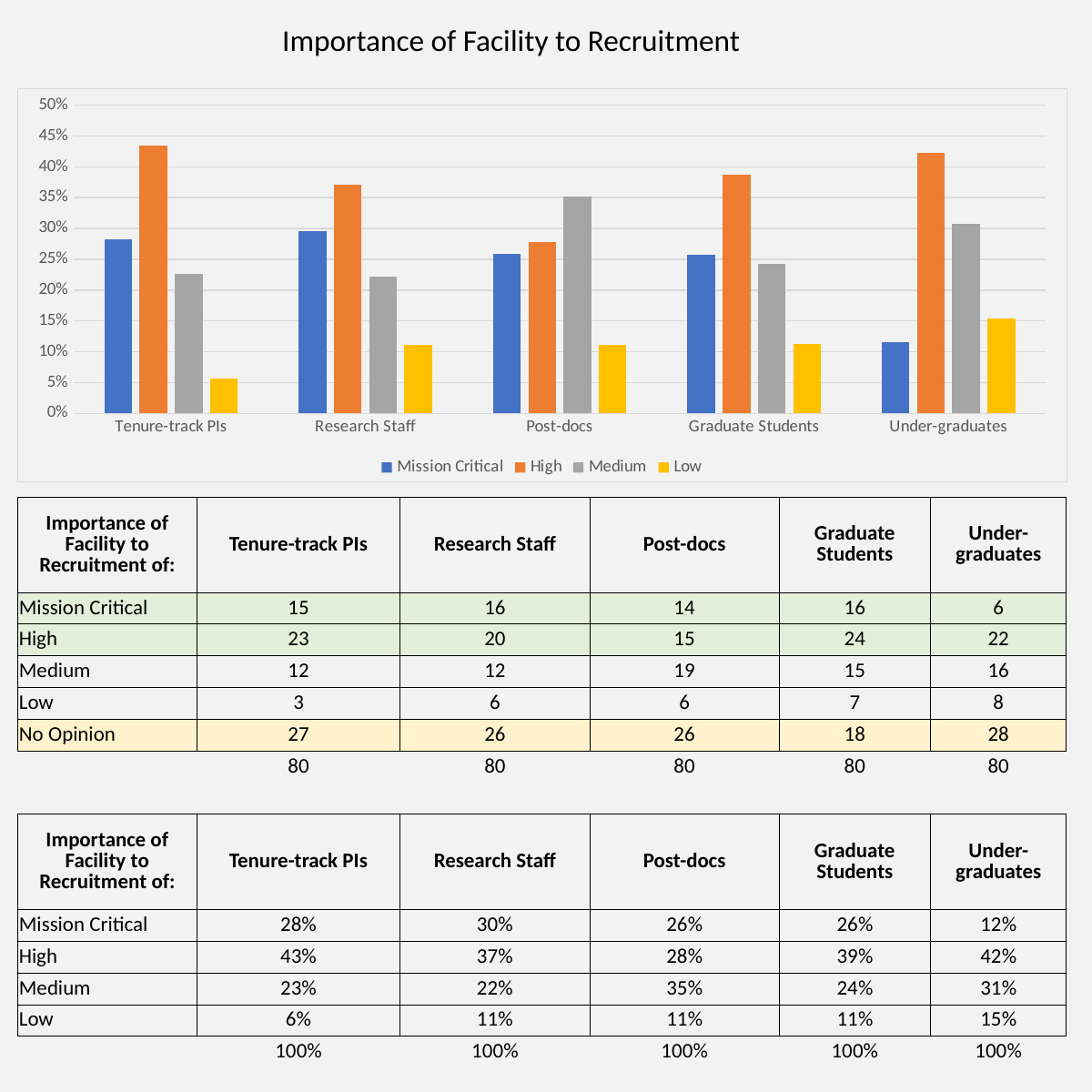
Which category has the highest Medium value in the chart? Post-docs What kind of chart is shown on the slide? bar chart How many categories are shown along the x axis of the chart? 5 Is the Medium value for Under-graduates greater or less than 25%? greater Is the Mission Critical value for Post-docs greater or less than 30%? less What colour represents the High series in the chart's legend? orange Is the High value for Tenure-track PIs greater or less than 40%? greater Which category has the lowest Low value in the chart? Tenure-track PIs How many series does the chart's legend list? 4 Which category has the lowest Mission Critical value in the chart? Under-graduates For Post-docs, which is larger in the chart: the High value or the Medium value? Medium For Under-graduates, which is larger in the chart: the Mission Critical value or the Low value? Low